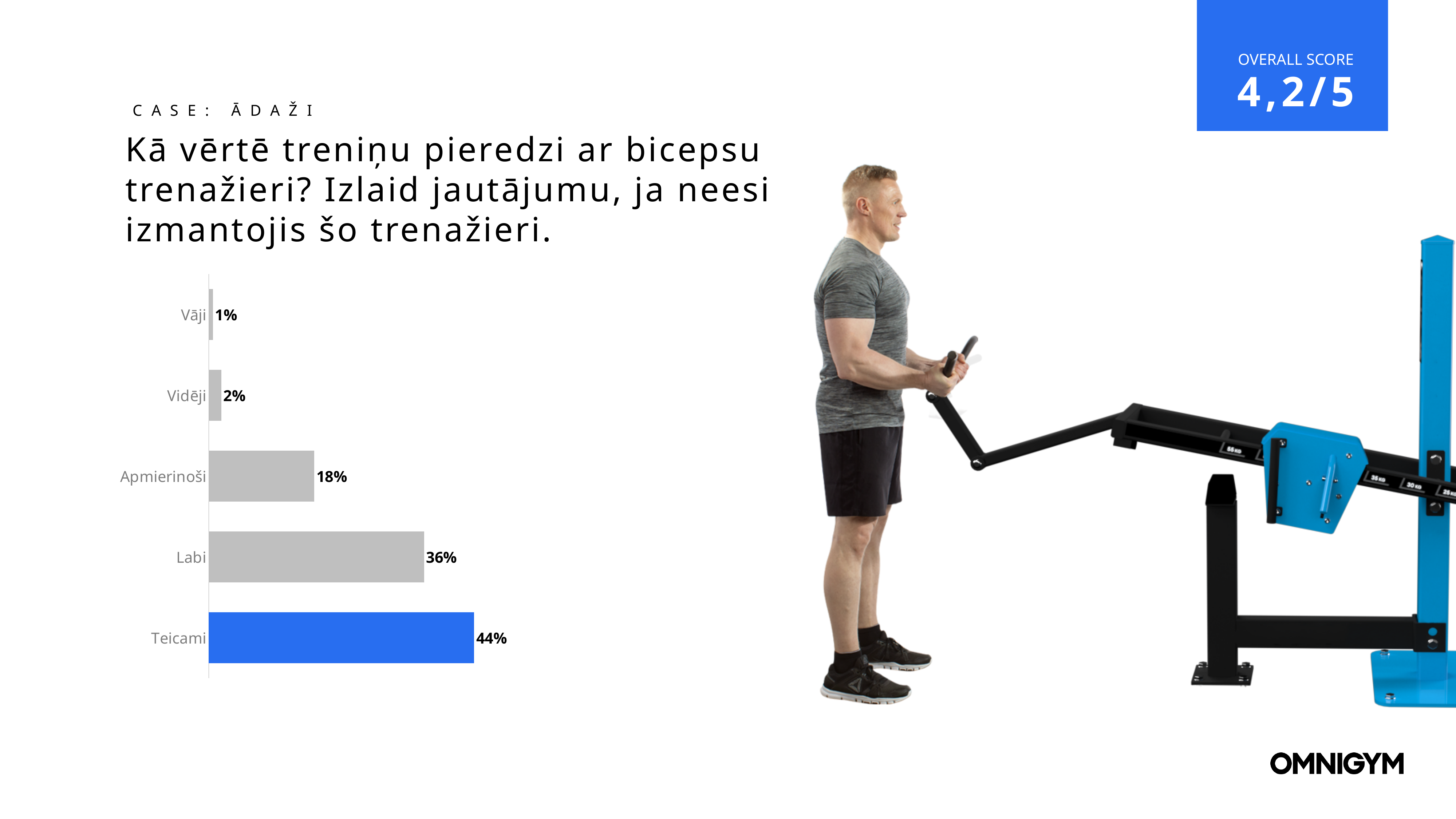
What is the difference between the values for "Teicami" and "Labi"? 8% What is the value shown for the "Labi" category? 36% What is the difference between the values for "Apmierinoši" and "Vidēji"? 16% Which is larger, the value for "Labi" or the value for "Apmierinoši"? Labi What percentage of respondents rated the biceps machine training experience as "Teicami"? 44% How many categories are shown in the chart? 5 What kind of chart is shown on the slide? Bar chart What is the value shown for the "Apmierinoši" category? 18% Which category has the lowest value in the chart? Vāji Which category has the highest value in the chart? Teicami What is the value shown for the "Vāji" category? 1% Which bar in the chart is coloured blue rather than grey? Teicami